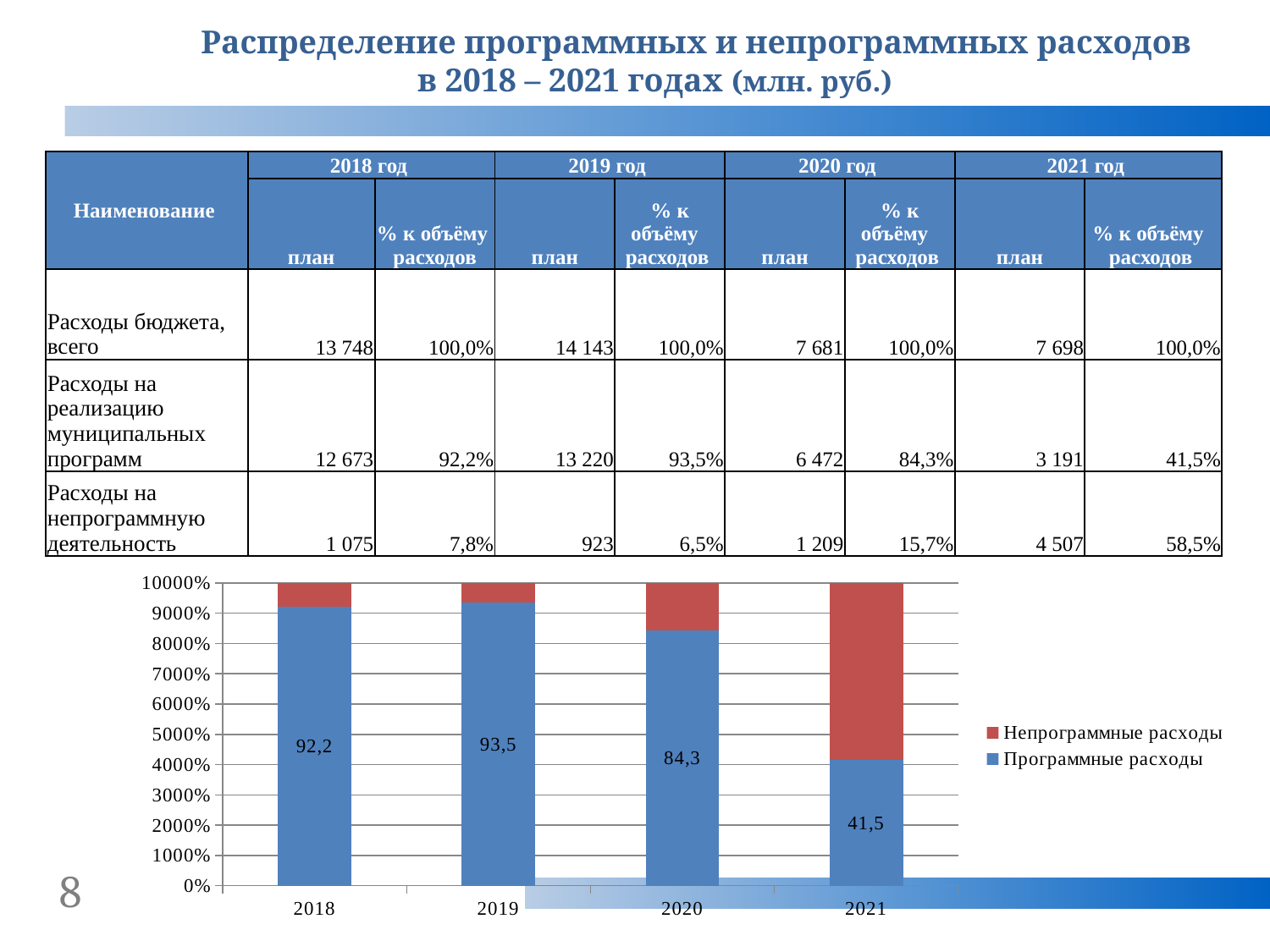
What is the data label on the Программные расходы bar for 2020? 84,3 What is the data label on the Программные расходы bar for 2021? 41,5 From 2019 to 2021, do the Программные расходы labels rise or fall? Fall In which year is the labelled Программные расходы value the lowest? 2021 How many series does the chart legend list? 2 In which year is the labelled Программные расходы value the highest? 2019 What kind of chart is shown on the slide? Stacked bar chart What is the data label on the Программные расходы bar for 2018? 92,2 What is the data label on the Программные расходы bar for 2019? 93,5 Which year has the larger Программные расходы label, 2018 or 2020? 2018 What is the difference between the Программные расходы labels for 2019 and 2021? 52,0 How many years are shown on the x axis of the chart? 4